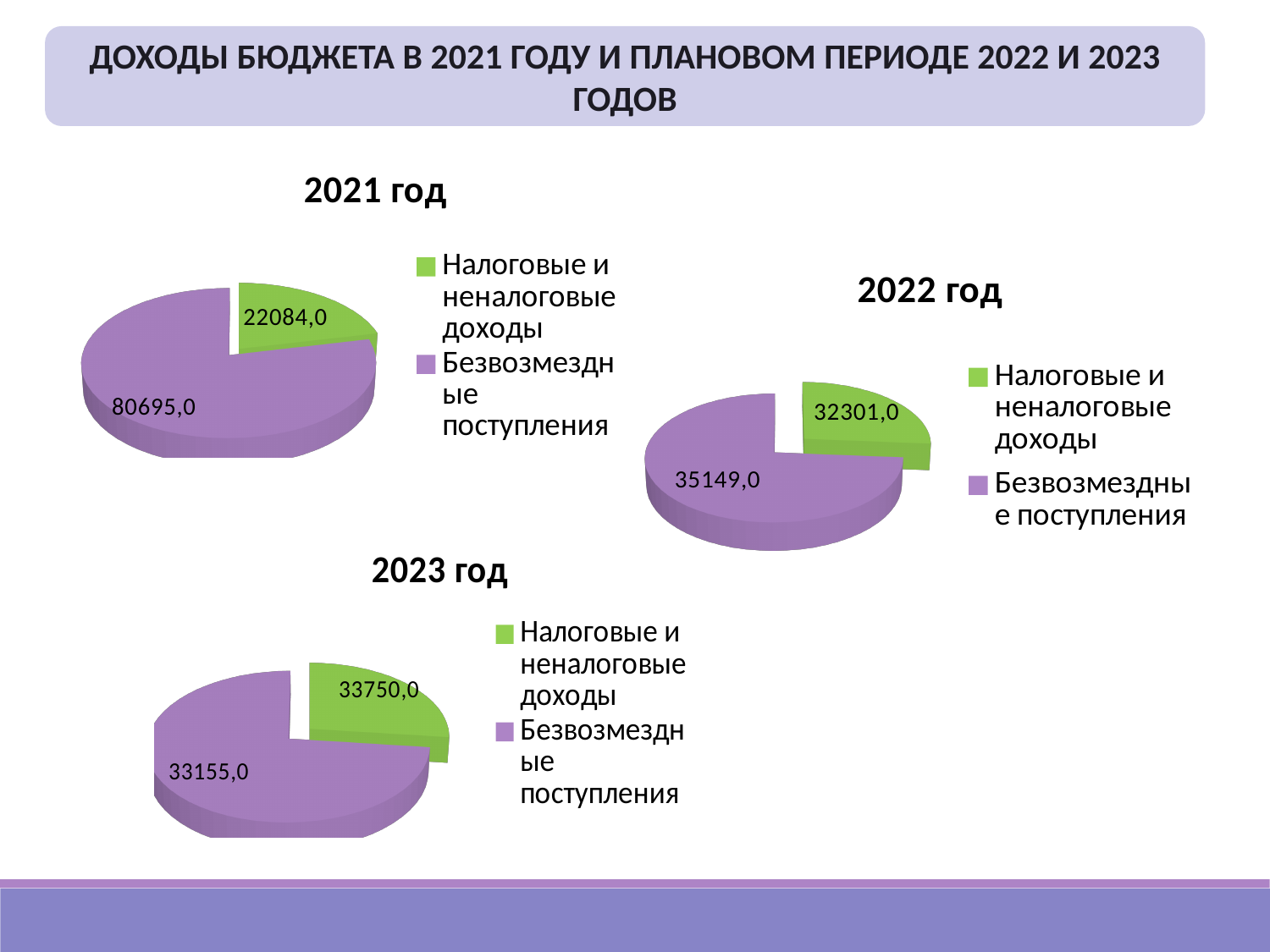
In the 2021 год chart, which category has the largest slice? Безвозмездные поступления In the 2022 год chart, is the value for Безвозмездные поступления larger or smaller than the value for Налоговые и неналоговые доходы? larger How many charts are shown on the slide? 3 In the 2022 год chart, what is the difference between Безвозмездные поступления and Налоговые и неналоговые доходы? 2848,0 In the 2022 год chart, which category has the smaller slice? Налоговые и неналоговые доходы In the 2021 год chart, what is the value for Безвозмездные поступления? 80695,0 In the 2022 год chart, what is the value for Налоговые и неналоговые доходы? 32301,0 In the 2021 год chart, what is the difference between Безвозмездные поступления and Налоговые и неналоговые доходы? 58611,0 In the 2021 год chart, what is the value for Налоговые и неналоговые доходы? 22084,0 In the 2023 год chart, what is the value for Безвозмездные поступления? 33155,0 What kind of chart is the 2023 год chart? pie chart How many slices does the 2022 год chart have? 2